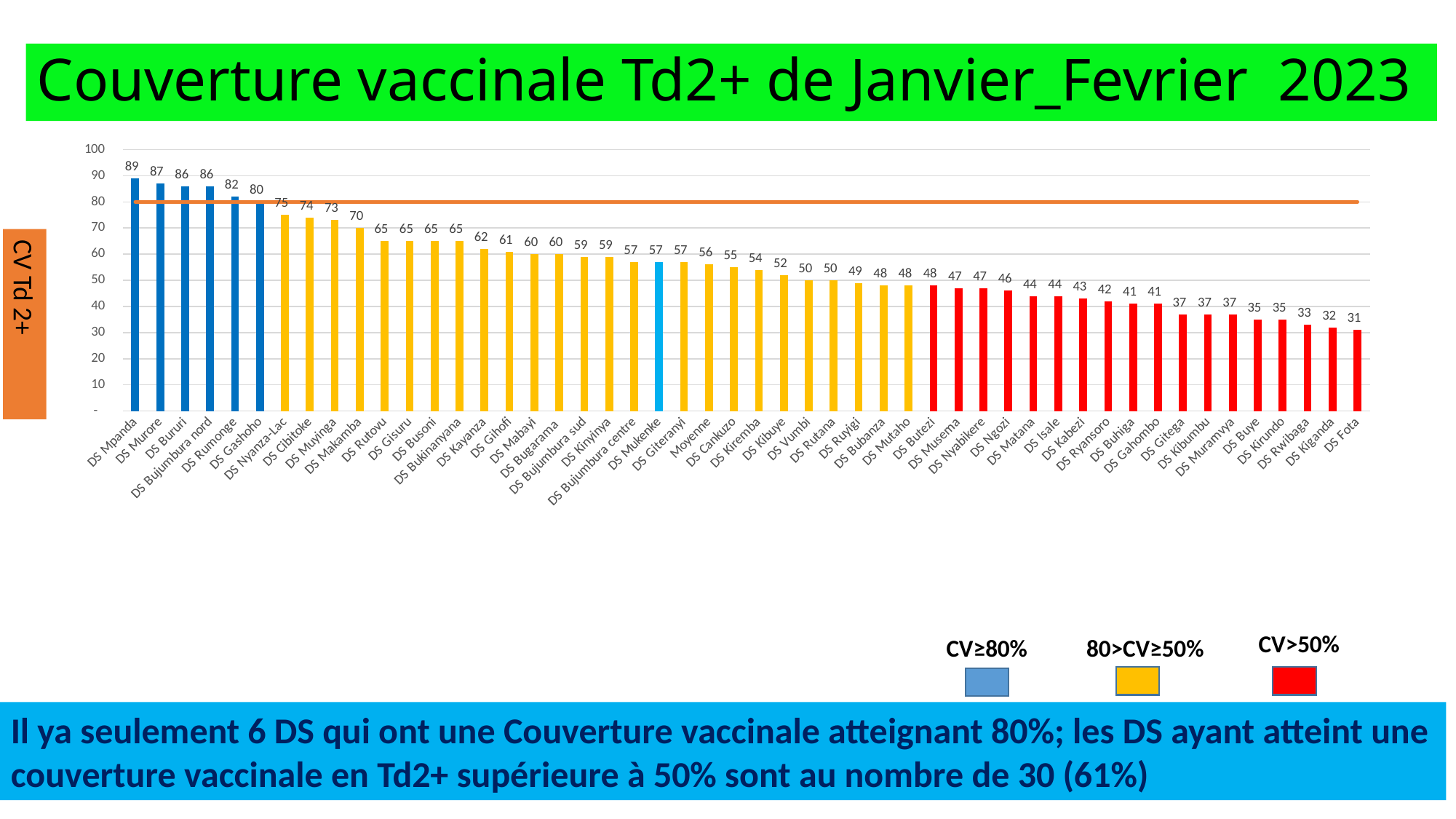
What is the difference between the values for DS Gashoho and DS Nyanza-Lac? 5 Which DS has the highest CV Td2+ value? DS Mpanda What is the value shown for DS Gitega? 37 What is the value shown for Moyenne? 56 Which has a higher value, DS Cibitoke or DS Kayanza? DS Cibitoke What is the value shown for DS Makamba? 70 Do the values rise or fall from left to right along the x axis? Fall At what value is the horizontal orange reference line drawn on the chart? 80 What type of chart is shown on the slide? Bar chart What is the difference between the values for DS Mpanda and DS Fota? 58 Which DS has the lowest CV Td2+ value? DS Fota What is the CV Td2+ value for DS Mpanda? 89